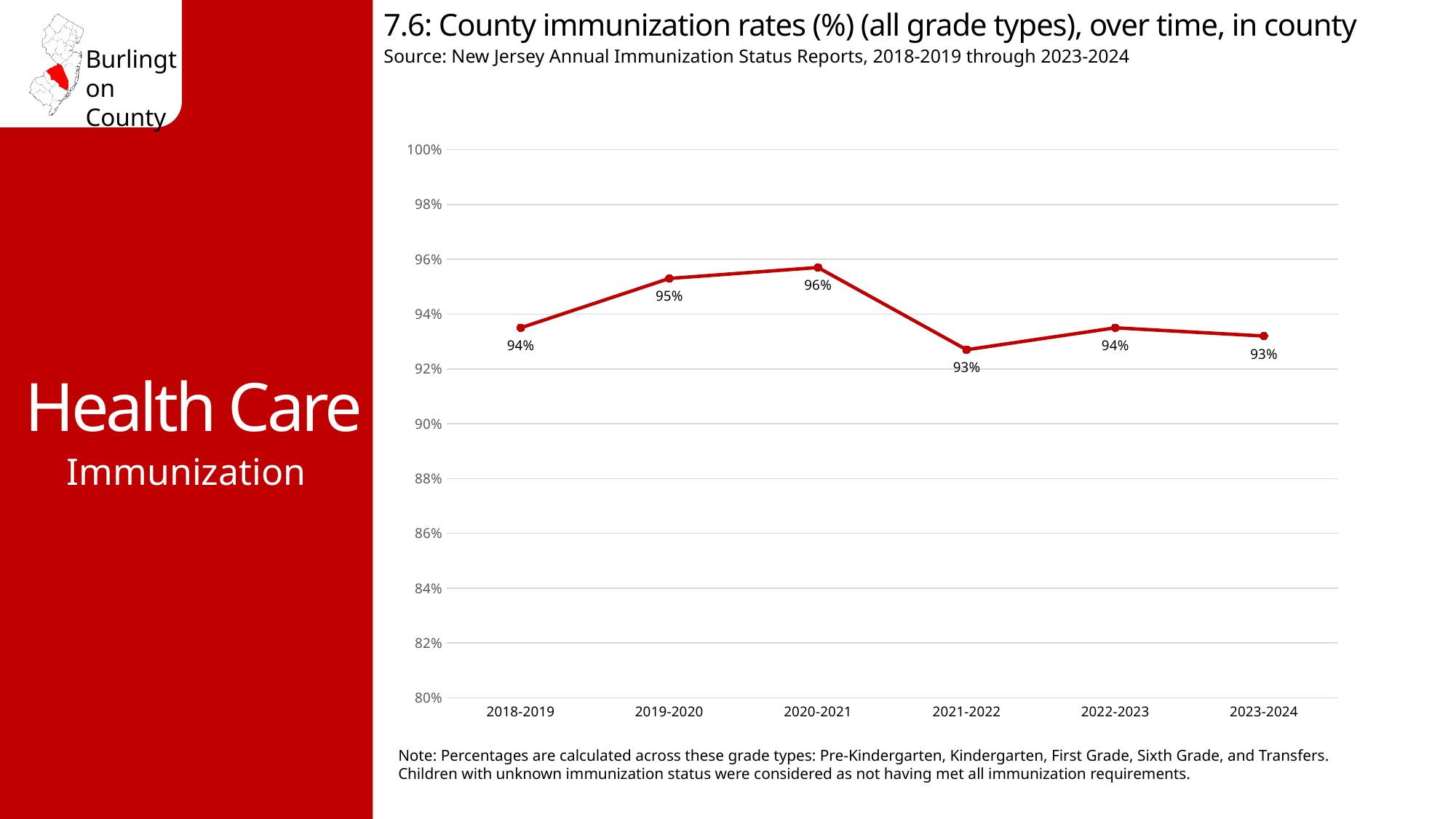
What was the county immunization rate in 2023-2024? 93% What was the county immunization rate in 2021-2022? 93% Which is larger, the immunization rate in 2019-2020 or in 2021-2022? 2019-2020 Which school year had the highest county immunization rate? 2020-2021 What type of chart is shown on the slide? Line chart What is the difference between the immunization rate in 2020-2021 and in 2021-2022? 3% What was the county immunization rate in 2020-2021? 96% What is the source cited for the chart data? New Jersey Annual Immunization Status Reports, 2018-2019 through 2023-2024 Between 2018-2019 and 2020-2021, does the immunization rate rise or fall? rise How many school years are plotted on the chart? 6 Is the immunization rate for 2021-2022 greater or less than 94%? less What was the county immunization rate in 2018-2019? 94%